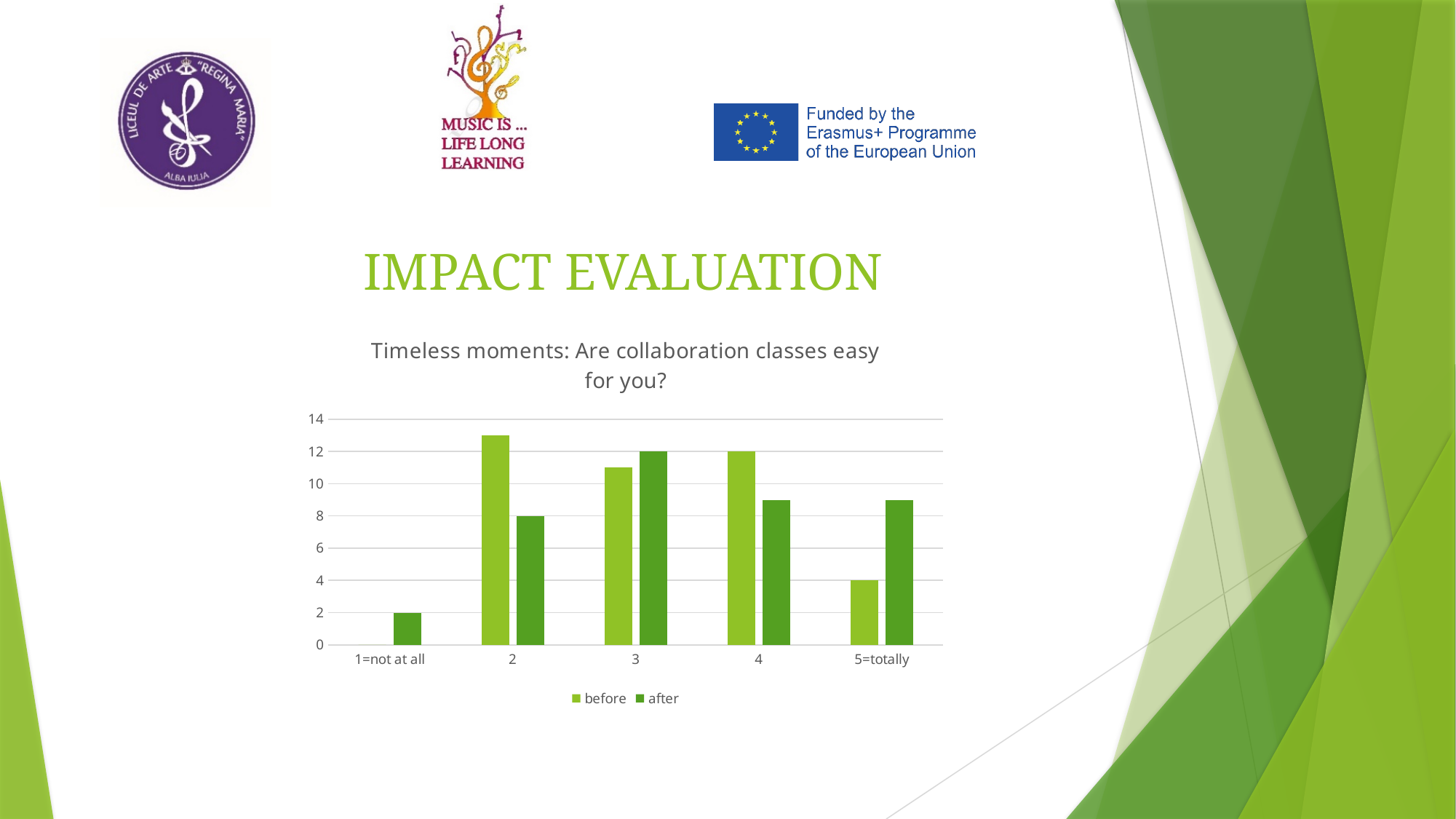
What is the value of the 'before' series for category 4? 12 Is the 'before' value for category 2 greater or less than 12? greater What is the difference between the 'after' values for category 3 and category 2? 4 How many series does the legend list? 2 Which category has the highest 'after' value? 3 What is the value of the 'after' series for category 3? 12 What is the value of the 'after' series for category 2? 8 For category 3, which is larger: the 'before' value or the 'after' value? after What is the value of the 'before' series for the category '5=totally'? 4 Which category has the lowest 'after' value? 1=not at all What is the value of the 'after' series for the category '1=not at all'? 2 Is the 'after' value for category 4 greater or less than 10? less